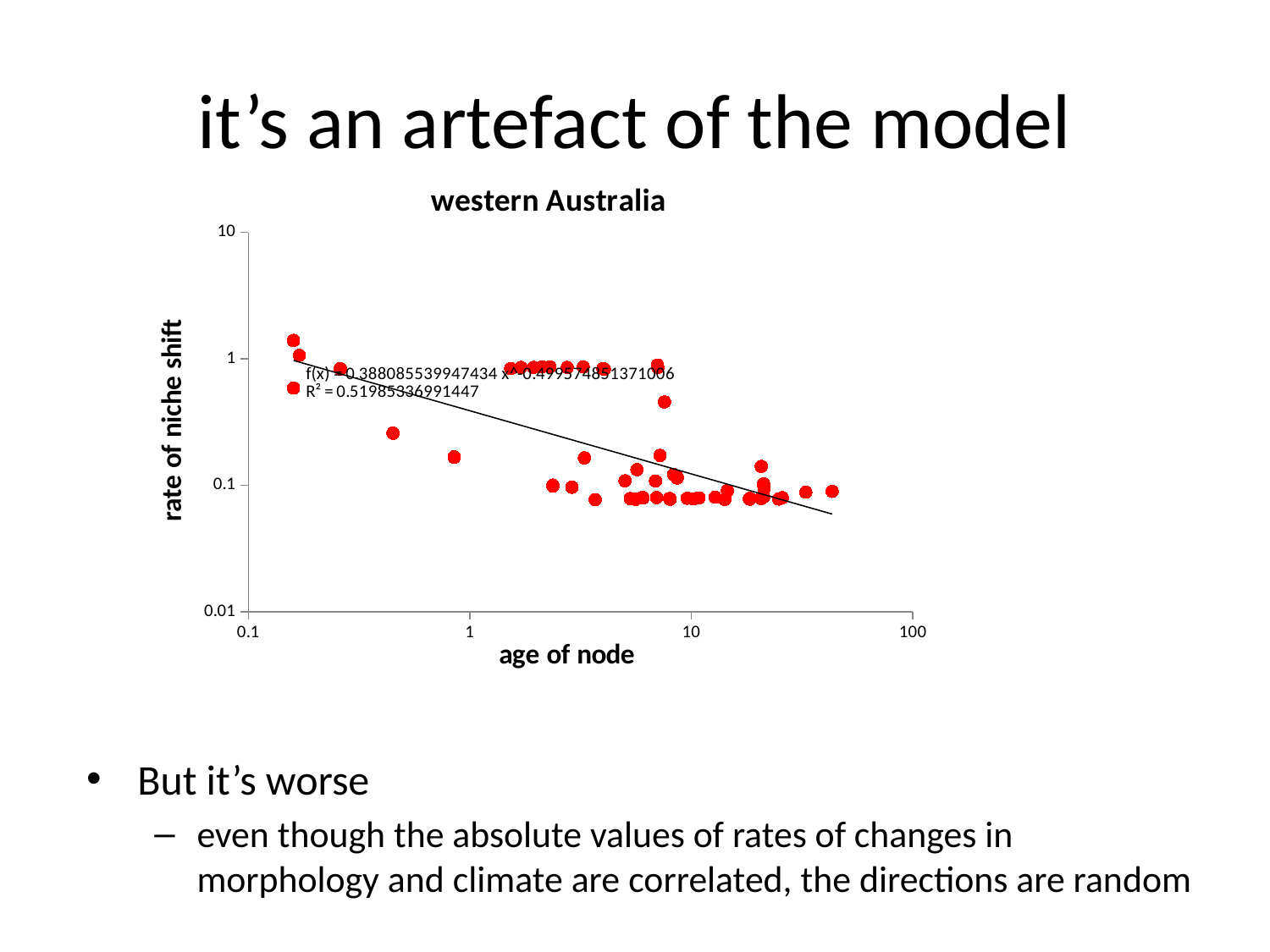
Is the rate of niche shift for the point at an age of node of about 0.9 greater or less than 0.1? greater What is the title of the chart? western Australia Is the highest rate of niche shift plotted greater or less than 1? greater Do the values of rate of niche shift generally rise or fall as age of node increases? fall What is the R² value shown for the trendline? 0.51985336991447 What is the maximum value shown on the y axis? 10 Is the rate of niche shift for the point at an age of node of about 0.5 greater or less than 0.1? greater What is the label of the x axis? age of node What kind of chart is shown on the slide? scatter plot